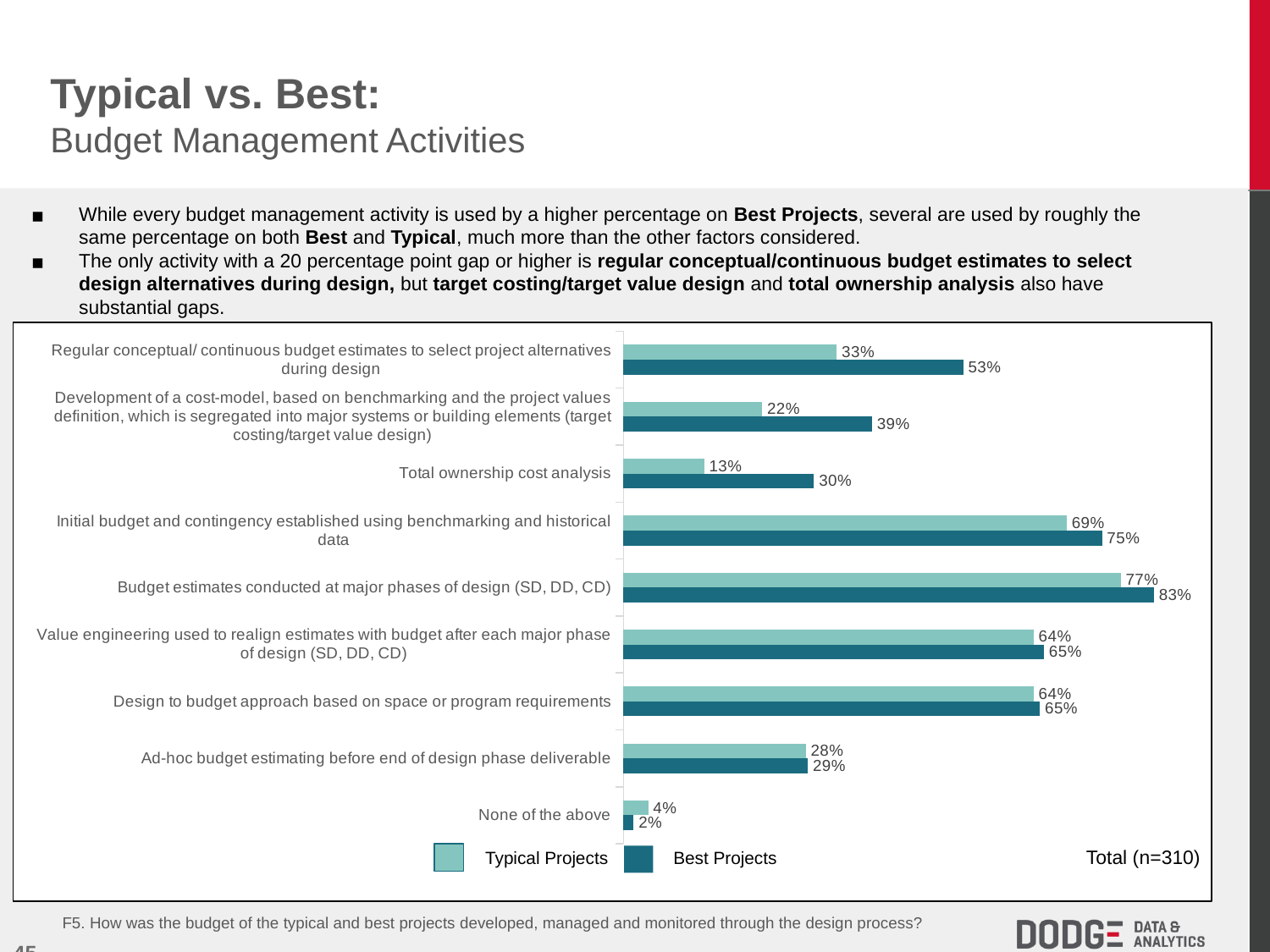
What type of chart is shown on the slide? Bar chart Which activity has the lowest percentage for Typical Projects, excluding 'None of the above'? Total ownership cost analysis Which activity has the highest percentage for Best Projects? Budget estimates conducted at major phases of design (SD, DD, CD) For 'None of the above', which is larger: the Typical Projects value or the Best Projects value? Typical Projects What is the Typical Projects value for 'Ad-hoc budget estimating before end of design phase deliverable'? 28% How many series does the chart legend list? 2 What percentage of Typical Projects used regular conceptual/continuous budget estimates to select project alternatives during design? 33% What percentage of Best Projects used total ownership cost analysis? 30% Is the Best Projects value for 'Initial budget and contingency established using benchmarking and historical data' greater or less than 70%? greater What is the difference between the Best Projects and Typical Projects values for regular conceptual/continuous budget estimates to select project alternatives during design? 20 percentage points What is the difference between Best Projects and Typical Projects for total ownership cost analysis? 17 percentage points How many activity categories are shown in the chart? 9